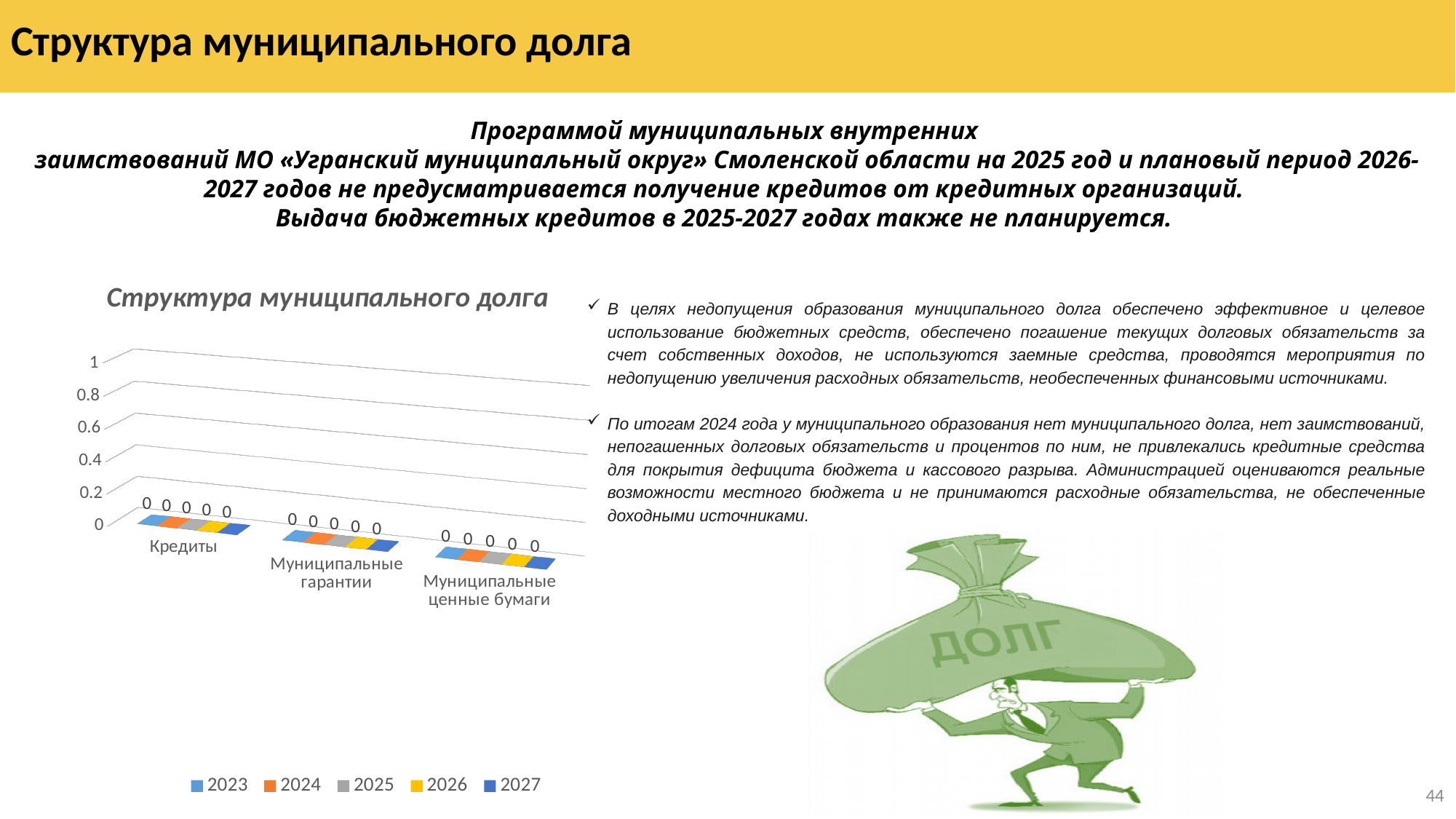
Which years are listed in the chart legend? 2023, 2024, 2025, 2026, 2027 What is the value for Муниципальные гарантии in 2025? 0 What is the total of all five years' values for Кредиты? 0 What is the value for Муниципальные ценные бумаги in 2027? 0 What is the value for Кредиты in 2023? 0 How many series does the chart legend list? 5 What is the value for Кредиты in 2026? 0 What is the highest tick value shown on the vertical axis of the chart? 1 How many categories are shown on the x axis of the chart? 3 What is the title of the chart? Структура муниципального долга Is the value for Муниципальные гарантии in 2024 greater or less than 0.2? less What kind of chart is shown on the slide? bar chart